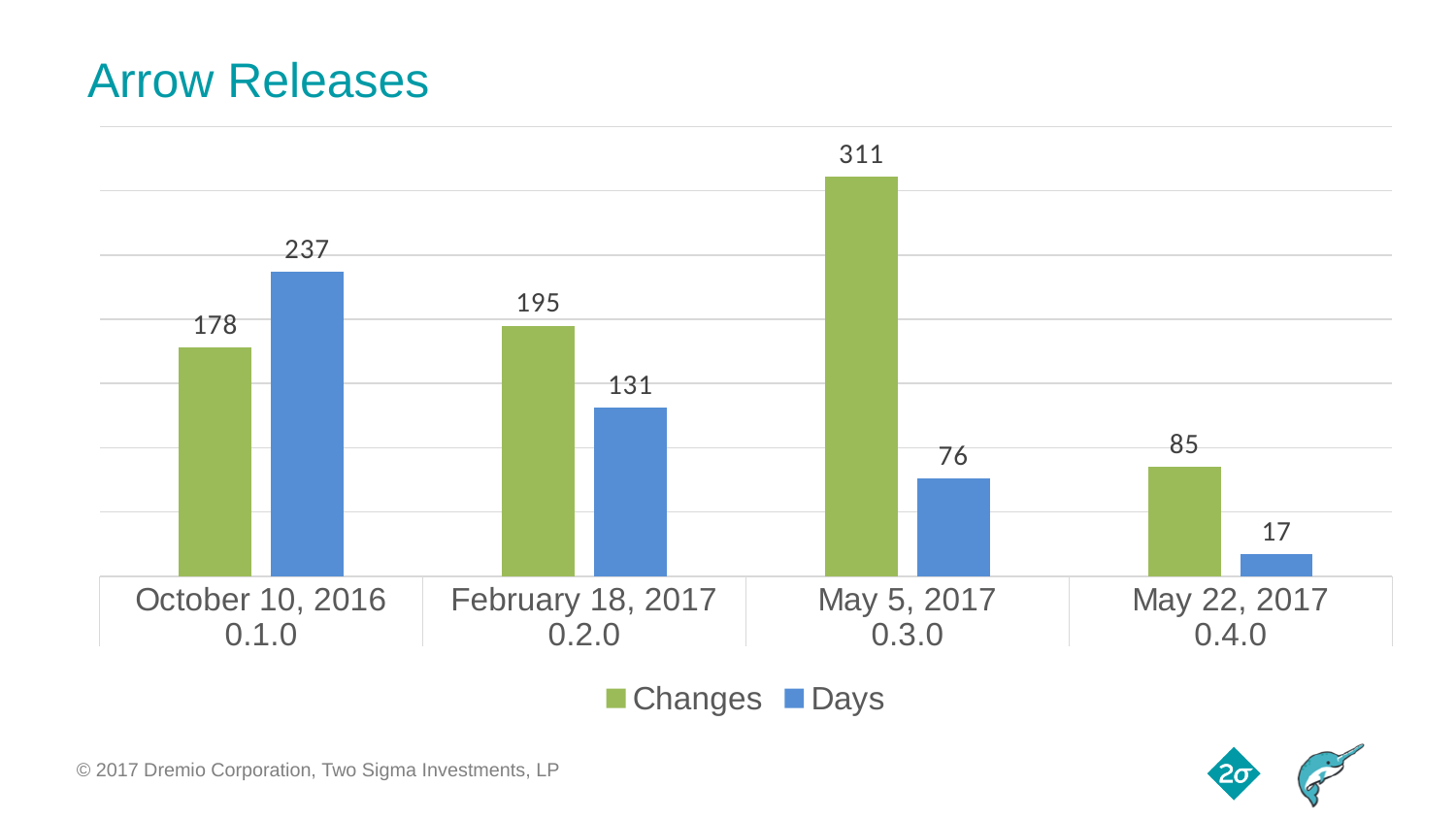
How many series does the legend list? 2 What is the value of Days for the 0.4.0 release (May 22, 2017)? 17 How many releases are shown on the x axis? 4 What is the title of the chart? Arrow Releases Do the Days values rise or fall across the releases from left to right? Fall What is the difference between Changes and Days for the 0.2.0 release (February 18, 2017)? 64 What is the value of Days for the 0.1.0 release (October 10, 2016)? 237 What is the value of Changes for the 0.3.0 release (May 5, 2017)? 311 Which release has the highest number of Changes? May 5, 2017 (0.3.0) What kind of chart is shown on the slide? Bar chart For the 0.1.0 release (October 10, 2016), which is larger, Changes or Days? Days Which release has the lowest number of Days? May 22, 2017 (0.4.0)